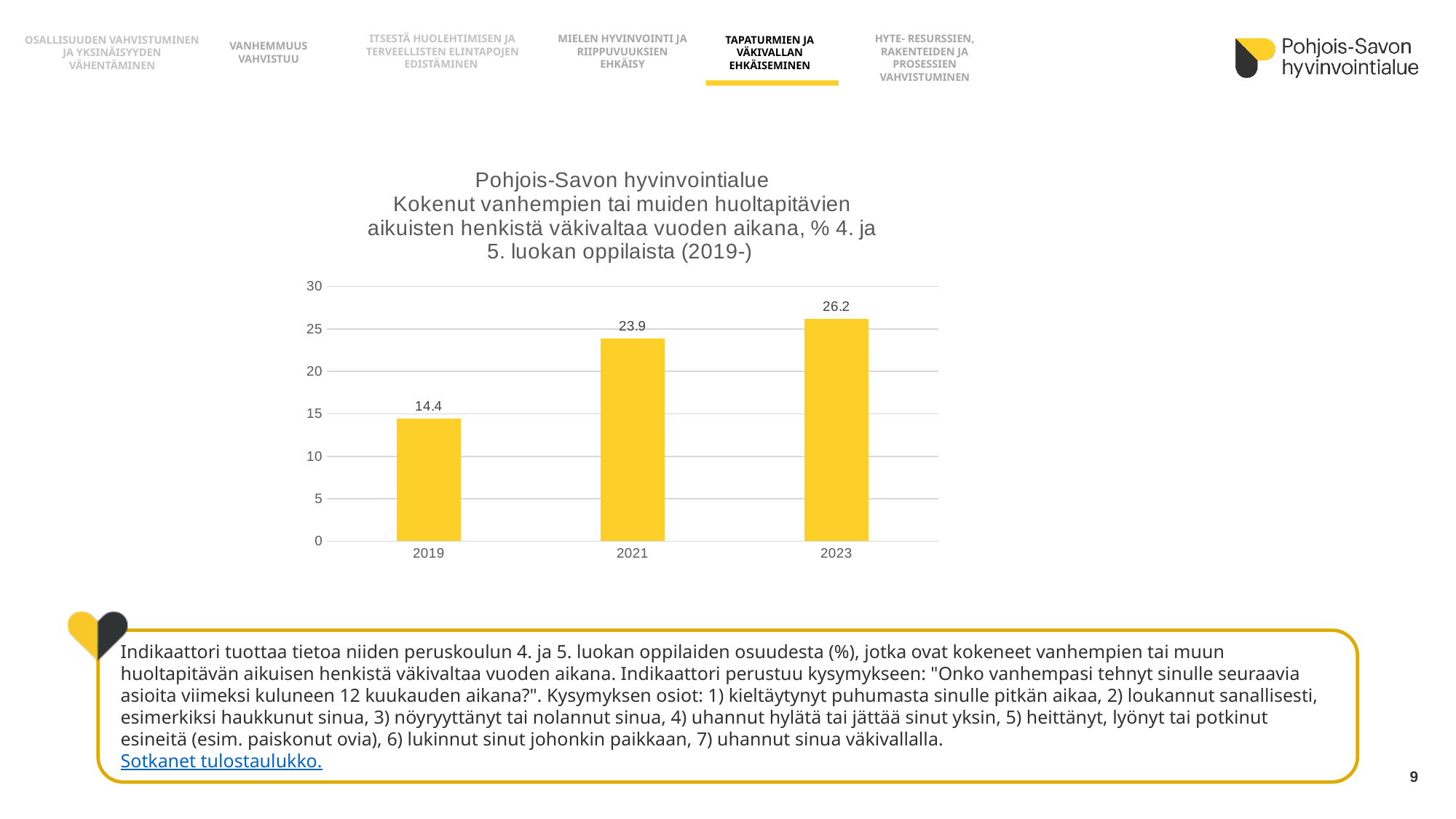
What is the difference between the values for 2023 and 2019? 11.8 What is the value for 2021? 23.9 Which year has the highest value? 2023 Is the value for 2019 greater or less than 15? less Which is larger, the value for 2021 or the value for 2023? 2023 Do the values rise or fall from 2019 to 2023? rise What is the value for 2019? 14.4 What is the value for 2023? 26.2 How many years are shown on the x axis? 3 What is the difference between the values for 2021 and 2019? 9.5 What kind of chart is shown on the slide? bar chart Which year has the lowest value? 2019